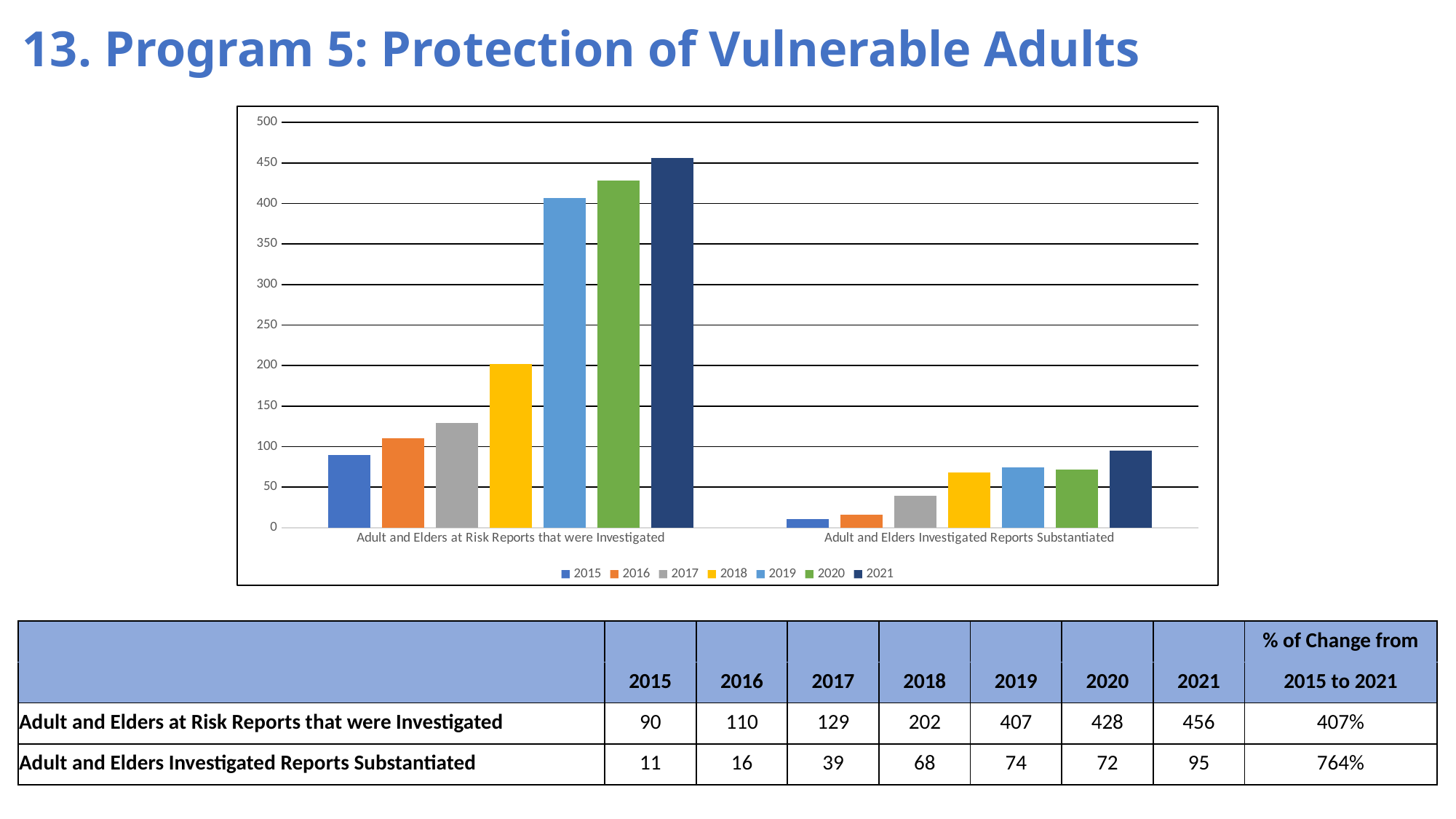
What kind of chart is shown on the slide? bar chart Which year has the lowest value for 'Adult and Elders Investigated Reports Substantiated'? 2015 How many series does the chart legend list? 7 How many categories are shown on the x axis of the chart? 2 What is the value for 2021 in the 'Adult and Elders at Risk Reports that were Investigated' category? 456 What is the value for 2017 in the 'Adult and Elders Investigated Reports Substantiated' category? 39 Which is larger: the 2019 value or the 2020 value for 'Adult and Elders Investigated Reports Substantiated'? 2019 Do the values for 'Adult and Elders at Risk Reports that were Investigated' rise or fall from 2015 to 2021? rise What colour are the bars for the 2018 series in the chart? yellow Which year has the highest value for 'Adult and Elders at Risk Reports that were Investigated'? 2021 Is the 2018 value for 'Adult and Elders at Risk Reports that were Investigated' greater or less than 200? greater What is the difference between the 2019 and 2018 values for 'Adult and Elders at Risk Reports that were Investigated'? 205